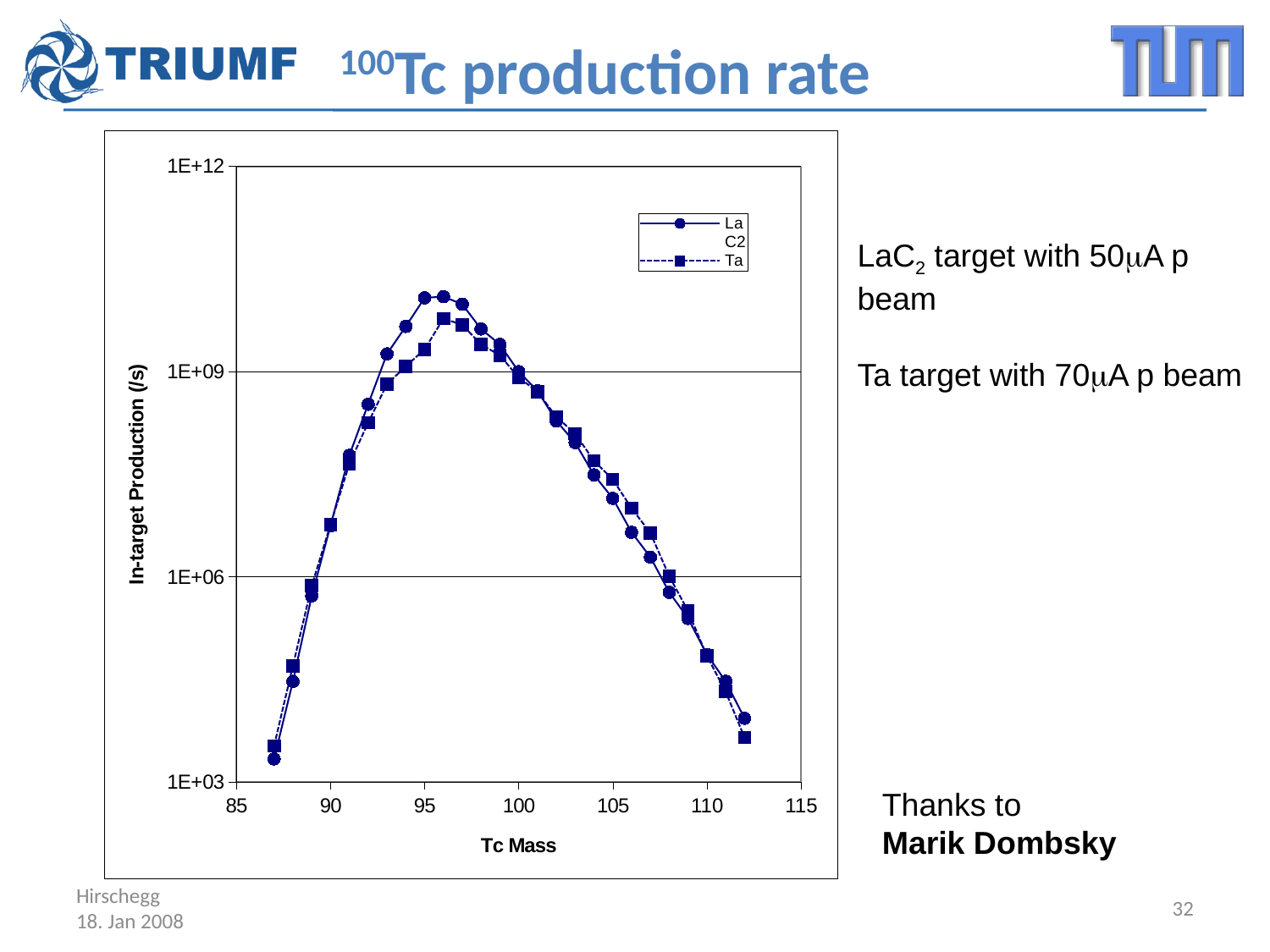
Is the Ta value at Tc mass 90 greater or less than 1E+06? greater How many series does the chart legend list? 2 What are the two series named in the chart legend? LaC2 and Ta At Tc mass 105, which series has the higher in-target production, LaC2 or Ta? Ta Is the LaC2 value at Tc mass 96 greater or less than 1E+09? greater At Tc mass 95, which series has the higher in-target production, LaC2 or Ta? LaC2 What is the label of the x axis of the chart? Tc Mass Do the in-target production values rise or fall as Tc mass increases from 100 to 112? fall Which series reaches the higher peak in-target production, LaC2 or Ta? LaC2 Is the LaC2 value at Tc mass 105 greater or less than 1E+09? less What kind of chart is shown on the slide? line chart